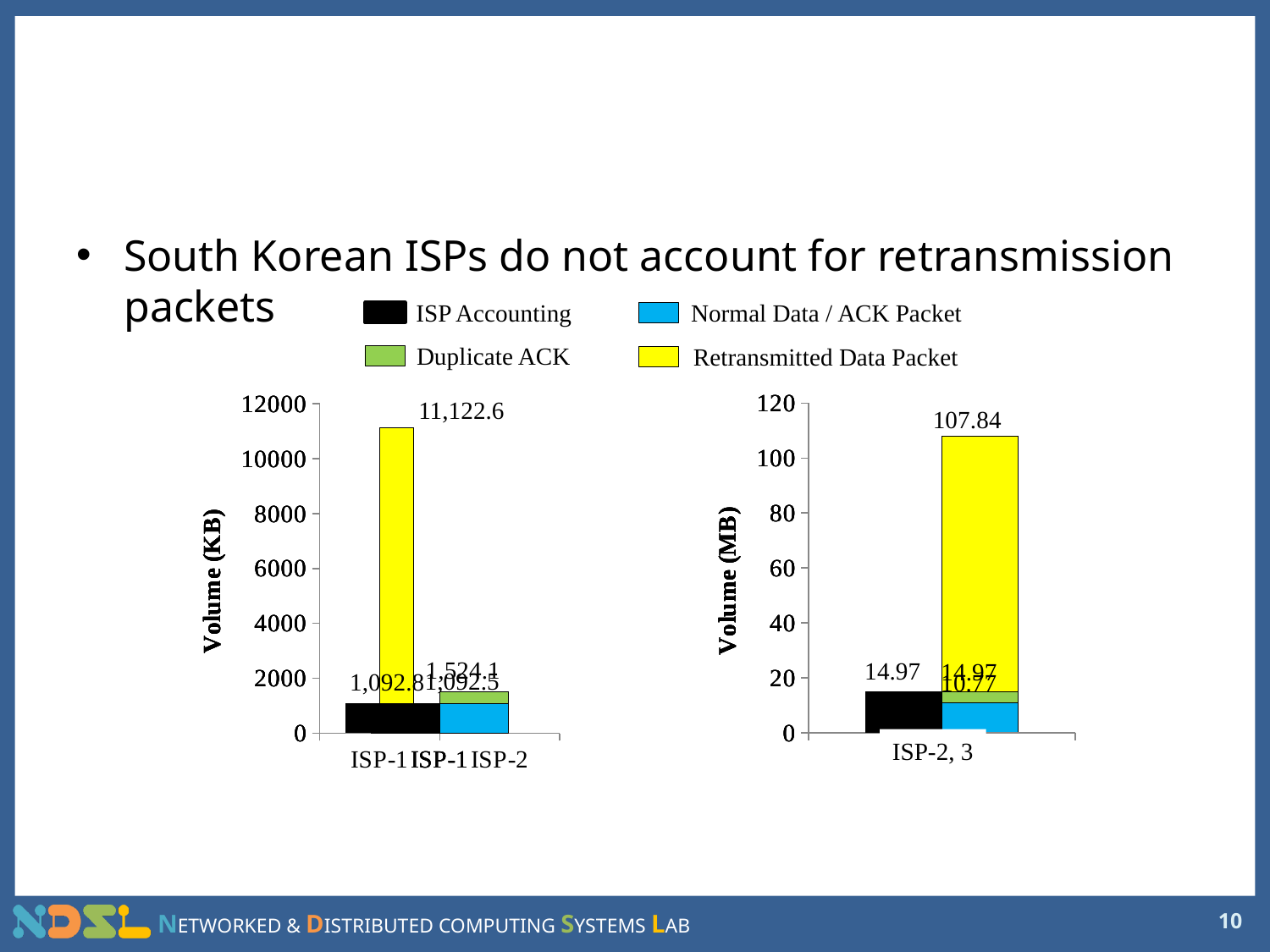
On the right chart (Volume (MB)), which series has the tallest bar? Retransmitted Data Packet On the left chart (Volume (KB)), what value is labelled on the Retransmitted Data Packet bar? 11,122.6 What is the y-axis label of the left chart? Volume (KB) On the left chart (Volume (KB)), is the ISP Accounting bar greater or less than 2000? less How many series does the shared legend list? 4 On the left chart (Volume (KB)), which is larger: the Retransmitted Data Packet bar or the ISP Accounting bar? Retransmitted Data Packet On the right chart (Volume (MB)), what value is labelled on the Retransmitted Data Packet bar? 107.84 What kind of chart is the right chart (Volume (MB))? bar chart Which series is shown in yellow in the legend? Retransmitted Data Packet On the right chart (Volume (MB)), is the Retransmitted Data Packet bar greater or less than 100? greater On the right chart (Volume (MB)), what is the difference between the Retransmitted Data Packet value and the ISP Accounting value? 92.87 On the right chart (Volume (MB)), what value is labelled on the ISP Accounting bar? 14.97